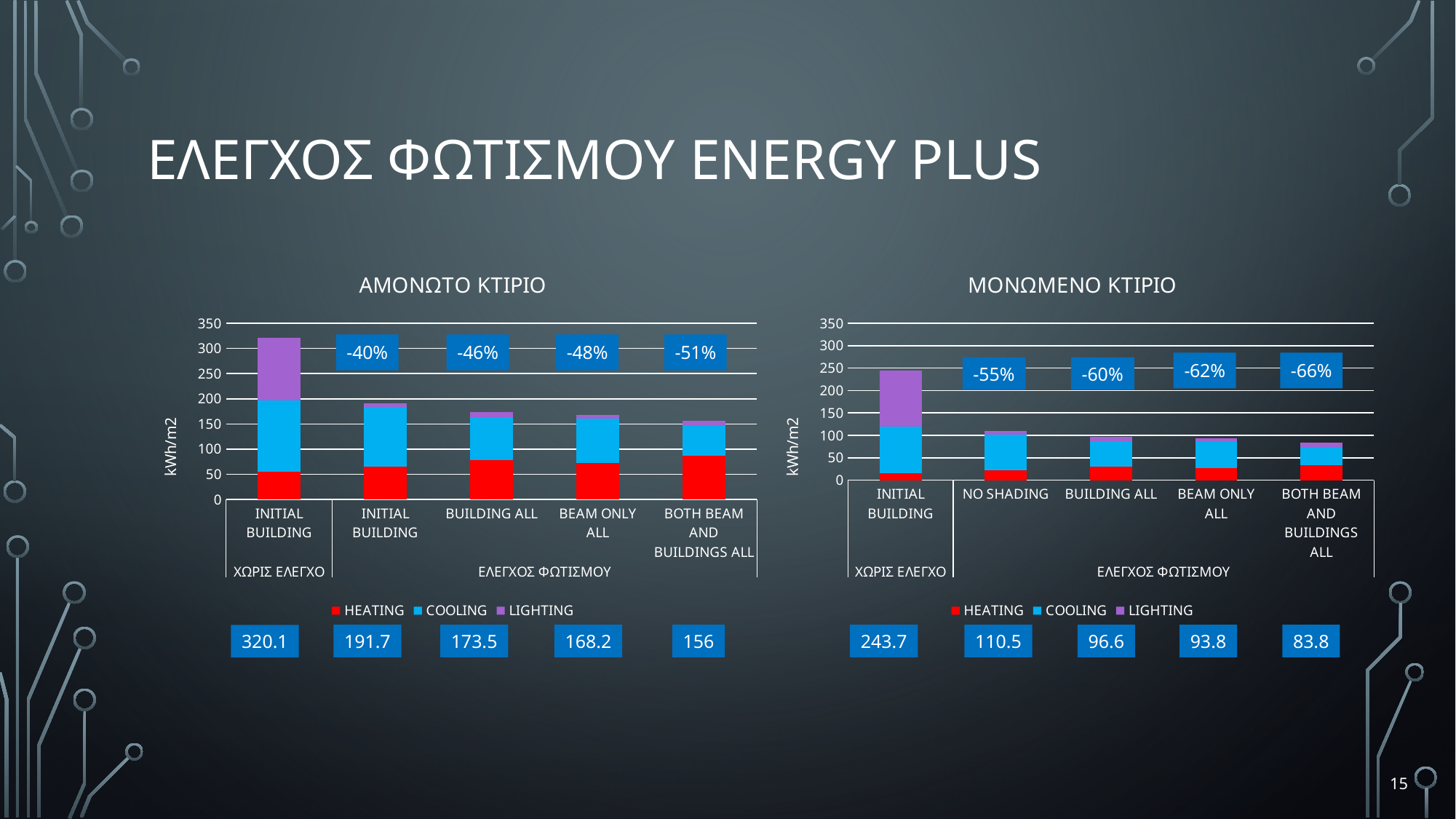
In the ΜΟΝΩΜΕΝΟ ΚΤΙΡΙΟ chart, what total value is printed below the BOTH BEAM AND BUILDINGS ALL bar? 83.8 In the ΑΜΟΝΩΤΟ ΚΤΙΡΙΟ chart, what percentage reduction is shown above the BEAM ONLY ALL bar? -48% In the ΜΟΝΩΜΕΝΟ ΚΤΙΡΙΟ chart, which bar has the highest total? INITIAL BUILDING In the ΜΟΝΩΜΕΝΟ ΚΤΙΡΙΟ chart, what percentage reduction is shown above the NO SHADING bar? -55% In the ΑΜΟΝΩΤΟ ΚΤΙΡΙΟ chart, what is the difference between the printed totals for INITIAL BUILDING under ΧΩΡΙΣ ΕΛΕΓΧΟ (320.1) and BUILDING ALL (173.5)? 146.6 In the ΑΜΟΝΩΤΟ ΚΤΙΡΙΟ chart, which bar has the lowest total? BOTH BEAM AND BUILDINGS ALL In the ΑΜΟΝΩΤΟ ΚΤΙΡΙΟ chart, what total value is printed below the INITIAL BUILDING bar under ΧΩΡΙΣ ΕΛΕΓΧΟ? 320.1 Which series is shown in red in the legend of both charts? HEATING How many series does the legend of the ΜΟΝΩΜΕΝΟ ΚΤΙΡΙΟ chart list? 3 How many bars are plotted in the ΑΜΟΝΩΤΟ ΚΤΙΡΙΟ chart? 5 What type of chart is the ΑΜΟΝΩΤΟ ΚΤΙΡΙΟ chart on the left? Stacked bar chart In the ΜΟΝΩΜΕΝΟ ΚΤΙΡΙΟ chart, is the total for the INITIAL BUILDING bar greater or less than 200? greater